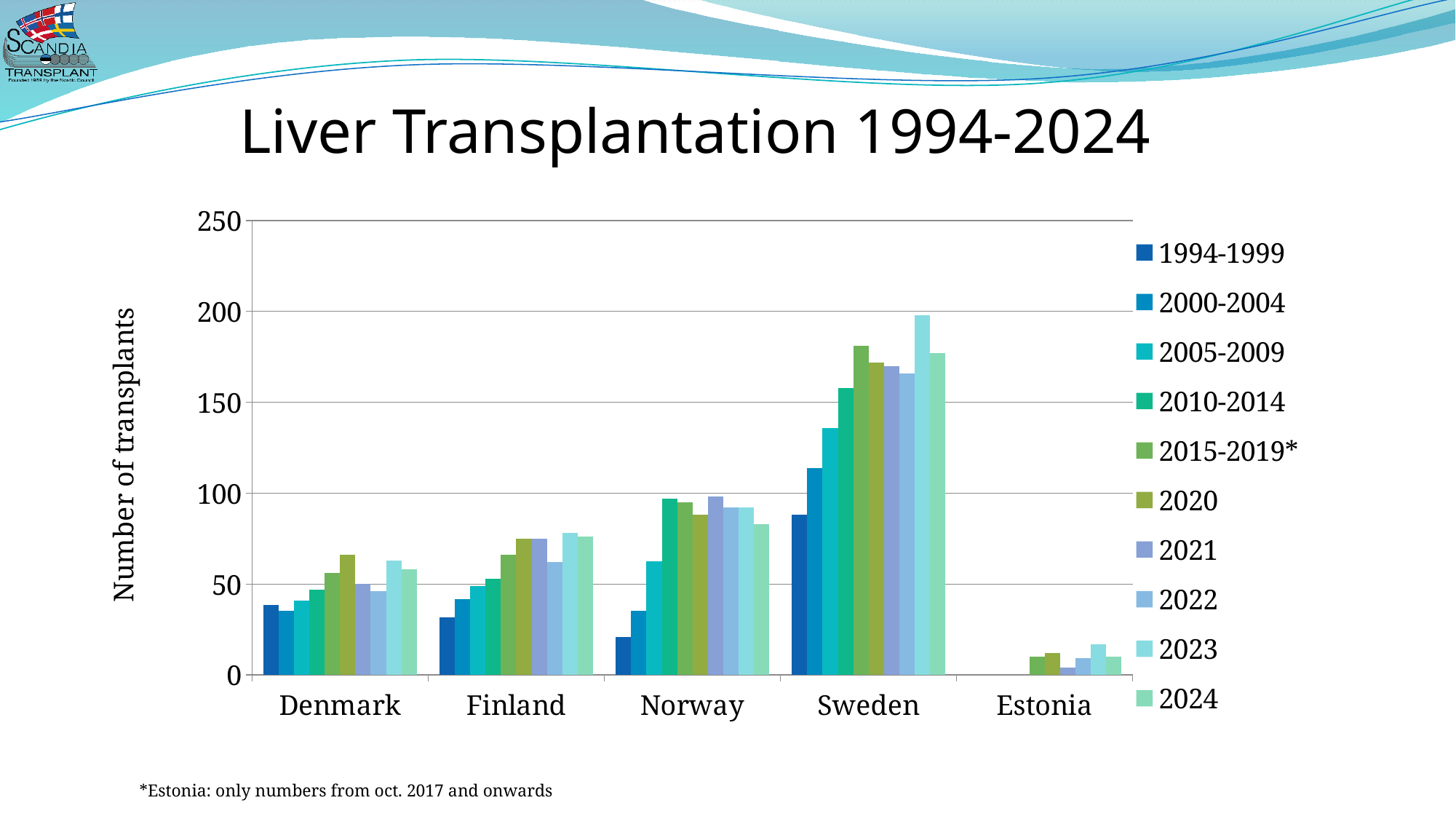
Is the value for Sweden in 2023 greater or less than 150? greater Do Sweden's values rise or fall from 1994-1999 through 2015-2019*? rise Is the value for Denmark in 2020 greater or less than 50? greater Which country has the highest bar for 2023? Sweden Is the value for Finland in 2023 greater or less than 100? less How many series does the legend list? 10 For Sweden, which is larger: the 2023 bar or the 2024 bar? 2023 What is the title of the y axis? Number of transplants What kind of chart is shown on the slide? bar chart How many countries are shown on the x axis of the chart? 5 Which country has the lowest bar for 2024? Estonia